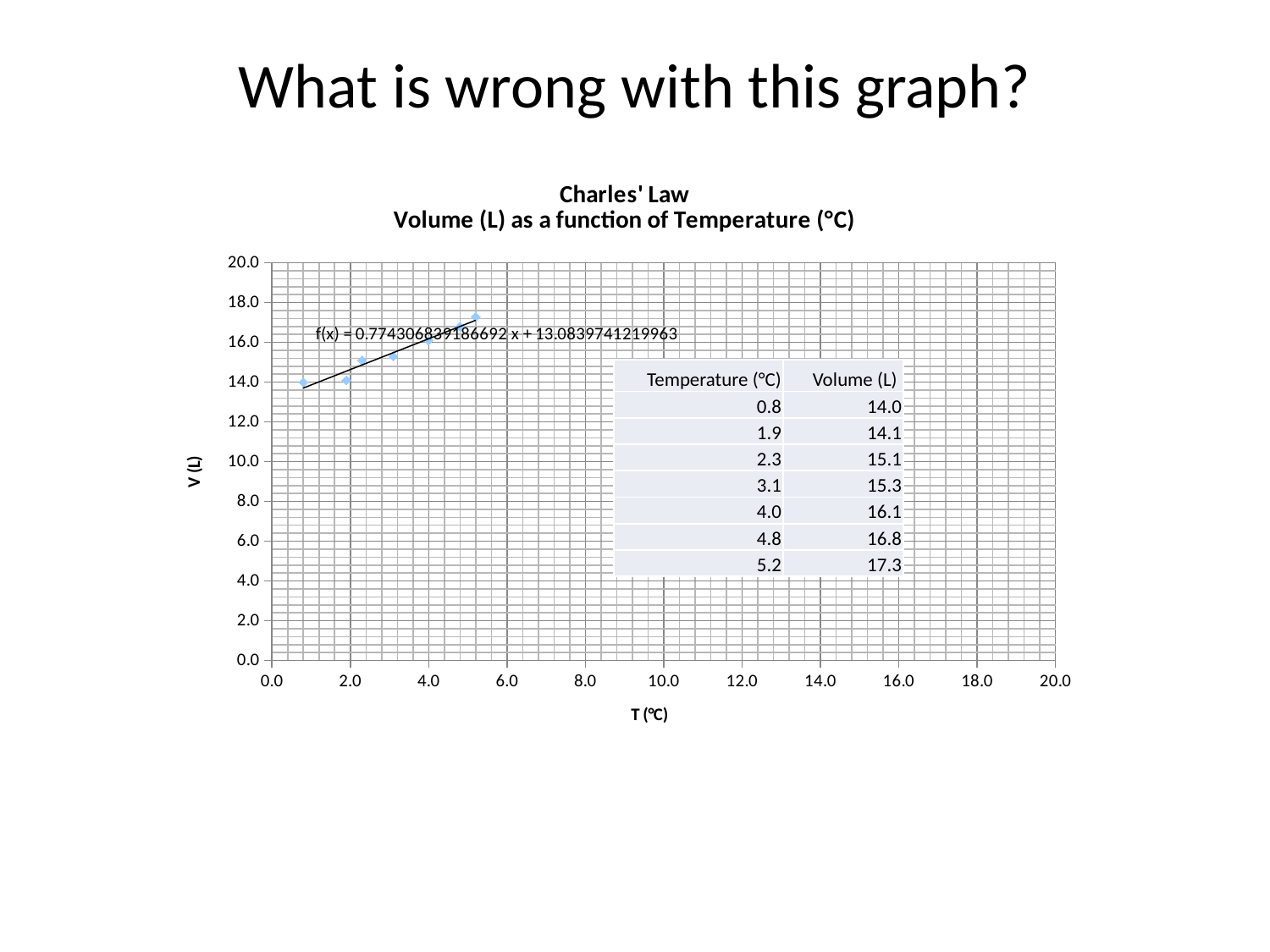
How many data points are plotted on the chart? 7 At which temperature is the volume lowest? 0.8 Is the volume at 5.2 °C greater or less than 16.0? greater At which temperature is the volume highest? 5.2 According to the data table, what is the volume at a temperature of 3.1 °C? 15.3 Do the plotted volume values rise or fall as temperature increases along the x axis? rise What kind of chart is shown on the slide? scatter chart Which is larger, the volume at 2.3 °C or the volume at 1.9 °C? 2.3 °C What is the difference between the highest volume (17.3 L) and the lowest volume (14.0 L)? 3.3 According to the data table, what is the volume at a temperature of 4.8 °C? 16.8 What is the title of the chart? Charles' Law Volume (L) as a function of Temperature (°C) What is the label of the chart's y axis? V (L)